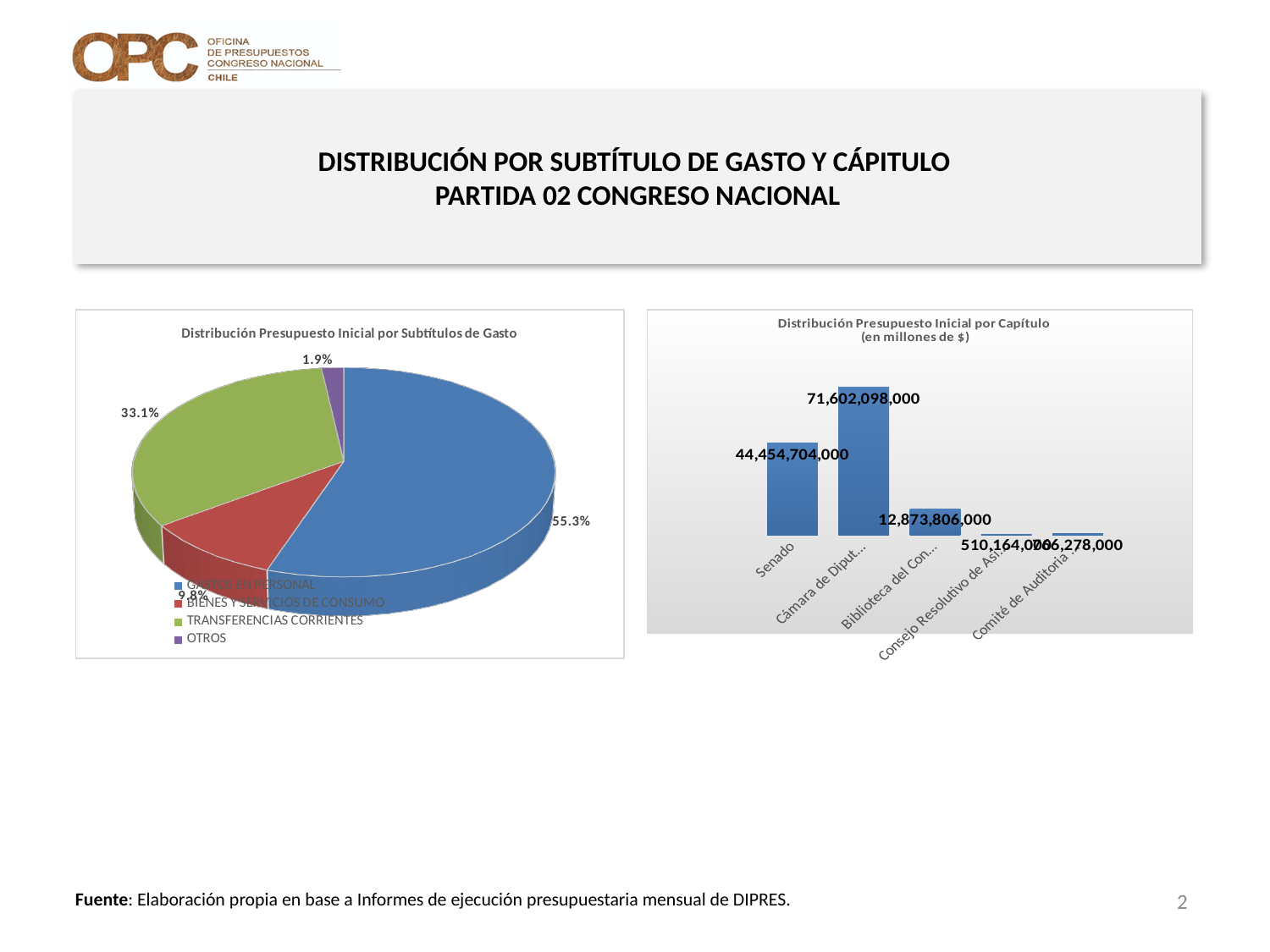
In the pie chart 'Distribución Presupuesto Inicial por Subtítulos de Gasto', what share does GASTOS EN PERSONAL have? 55.3% In the pie chart 'Distribución Presupuesto Inicial por Subtítulos de Gasto', how many categories does the legend list? 4 What kind of chart is 'Distribución Presupuesto Inicial por Capítulo'? Bar chart In the chart 'Distribución Presupuesto Inicial por Capítulo', which category has the highest value? Cámara de Diput... In the chart 'Distribución Presupuesto Inicial por Capítulo', what is the difference between the value for Cámara de Diput... and the value for Senado? 27,147,394,000 In the pie chart 'Distribución Presupuesto Inicial por Subtítulos de Gasto', which category has the smallest share? OTROS In the pie chart 'Distribución Presupuesto Inicial por Subtítulos de Gasto', what share does OTROS have? 1.9% In the chart 'Distribución Presupuesto Inicial por Capítulo', which is larger, the value for Senado or the value for Biblioteca del Con...? Senado In the pie chart 'Distribución Presupuesto Inicial por Subtítulos de Gasto', how many percentage points larger is the GASTOS EN PERSONAL share than the TRANSFERENCIAS CORRIENTES share? 22.2 percentage points In the pie chart 'Distribución Presupuesto Inicial por Subtítulos de Gasto', what share does TRANSFERENCIAS CORRIENTES have? 33.1% In the pie chart 'Distribución Presupuesto Inicial por Subtítulos de Gasto', which category has the largest share? GASTOS EN PERSONAL In the chart 'Distribución Presupuesto Inicial por Capítulo', what is the value for Senado? 44,454,704,000